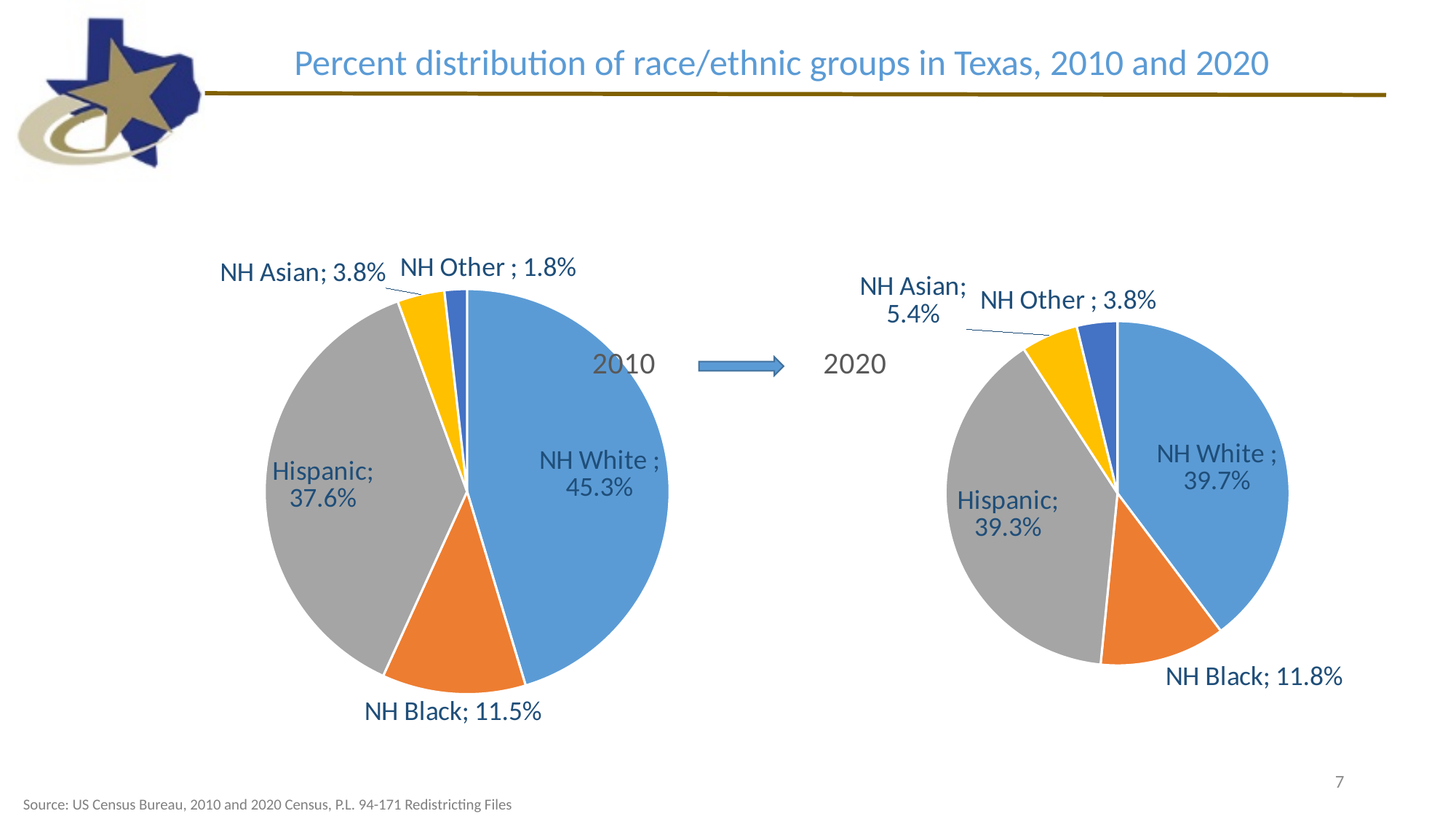
In the 2010 pie chart, which group has the largest share? NH White In the 2010 pie chart, what is the share for NH Other? 1.8% In the 2020 pie chart, which is larger: the NH Black share or the NH Asian share? NH Black How many groups are shown in the 2020 pie chart? 5 In the 2010 pie chart, what is the difference between the NH White share and the Hispanic share? 7.7% In the 2020 pie chart, which group has the smallest share? NH Other What kind of chart is used on this slide? Pie chart In the 2020 pie chart, what is the share for Hispanic? 39.3% What is the difference between the NH Black share in 2020 and in 2010? 0.3% What colour is the Hispanic slice in both pie charts? Gray In the 2010 pie chart, what is the share for NH White? 45.3% In the 2020 pie chart, what is the share for NH Asian? 5.4%